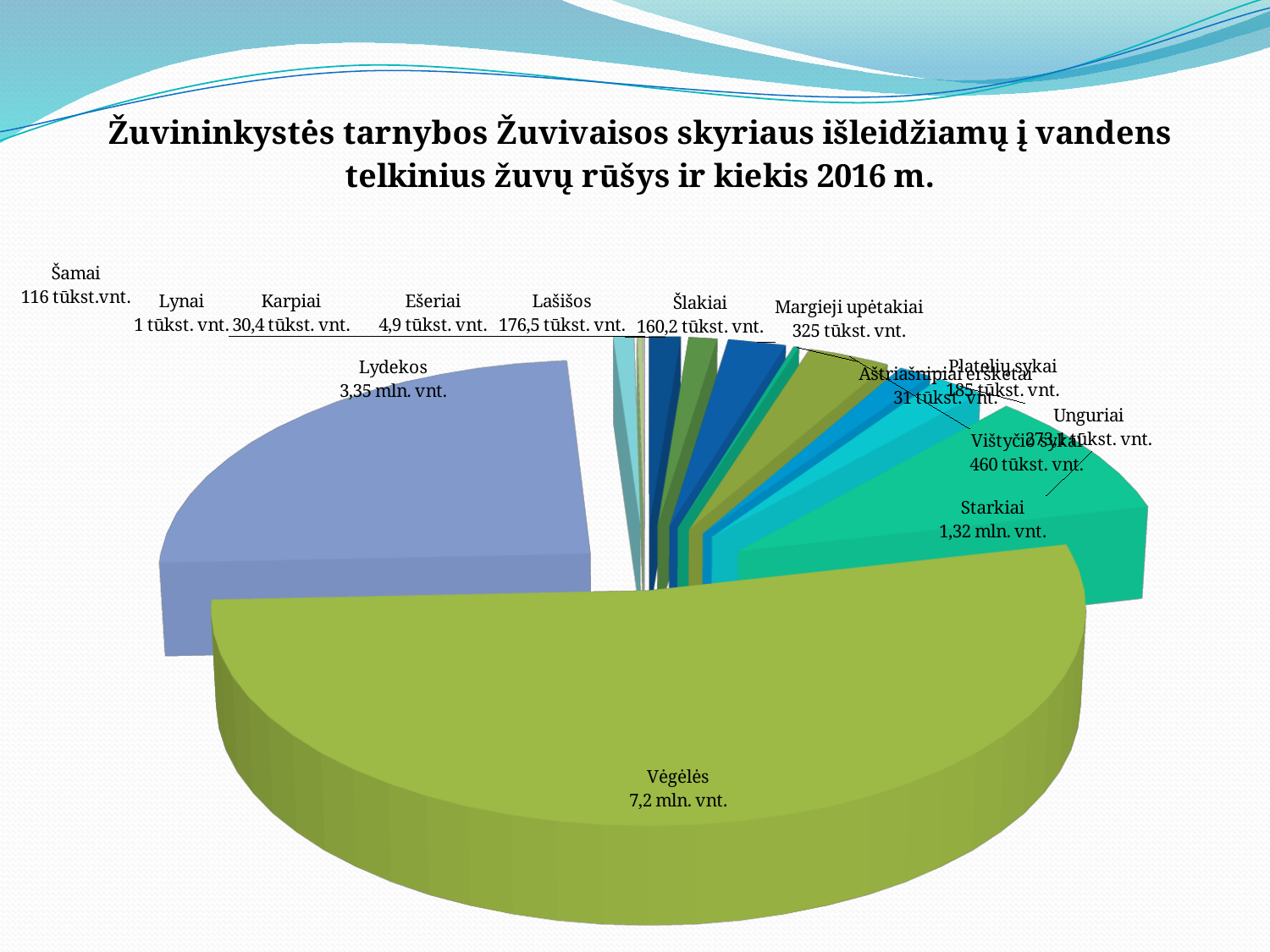
What is the value shown for Starkiai? 1,32 mln. vnt. Which is larger, the value for Lašišos or the value for Šlakiai? Lašišos What type of chart is shown on the slide? pie chart Which fish species has the largest slice of the pie? Vėgėlės What is the value shown for Karpiai? 30,4 tūkst. vnt. What is the difference between the values for Lašišos and Šlakiai? 16,3 tūkst. vnt. Which fish species has the smallest value shown? Lynai What is the value shown for Lydekos? 3,35 mln. vnt. What is the difference between the values for Lydekos and Starkiai? 2,03 mln. vnt. What is the value shown for Lašišos? 176,5 tūkst. vnt. What is the value shown for Vėgėlės? 7,2 mln. vnt. What is the value shown for Margieji upėtakiai? 325 tūkst. vnt.